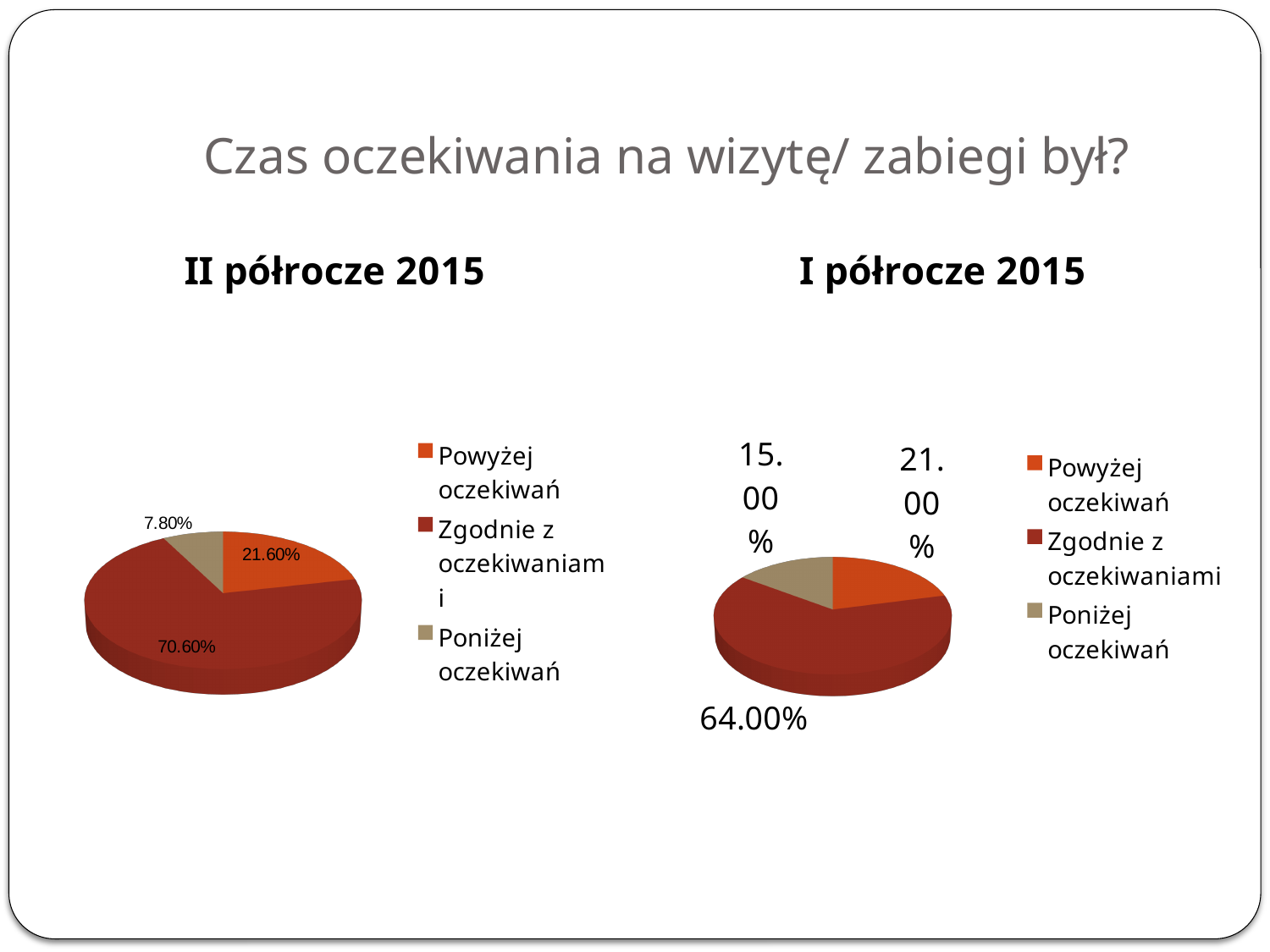
Which is larger: 'Poniżej oczekiwań' in the 'II półrocze 2015' chart or 'Poniżej oczekiwań' in the 'I półrocze 2015' chart? I półrocze 2015 How many categories does the 'I półrocze 2015' chart show? 3 In the 'I półrocze 2015' chart, which category has the smallest slice? Poniżej oczekiwań In the 'I półrocze 2015' chart, what is the value for 'Zgodnie z oczekiwaniami'? 64.00% What kind of chart is the 'II półrocze 2015' chart? Pie chart In the 'I półrocze 2015' chart, what is the difference between 'Zgodnie z oczekiwaniami' and 'Powyżej oczekiwań'? 43.00% In the 'II półrocze 2015' chart, what is the value for 'Poniżej oczekiwań'? 7.80% In the 'II półrocze 2015' chart, what is the difference between 'Powyżej oczekiwań' and 'Poniżej oczekiwań'? 13.80% In the 'I półrocze 2015' chart, what is the value for 'Powyżej oczekiwań'? 21.00% In the 'II półrocze 2015' chart, what colour is the 'Powyżej oczekiwań' slice? Orange In the 'II półrocze 2015' chart, which category has the largest slice? Zgodnie z oczekiwaniami In the 'II półrocze 2015' chart, what is the value for 'Zgodnie z oczekiwaniami'? 70.60%